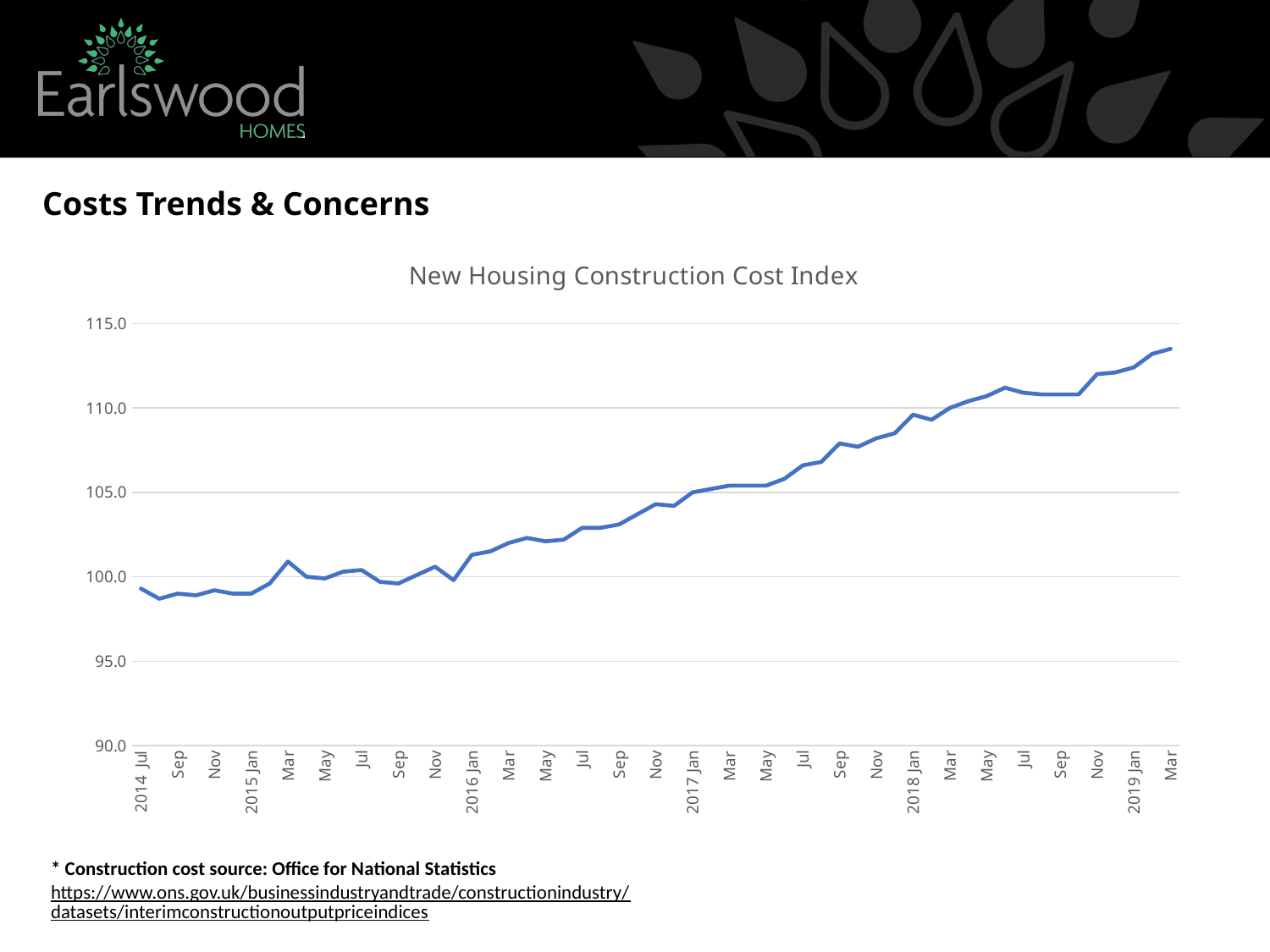
Is the value for 2017 Jul greater or less than 105.0? greater Is the value for 2014 Jul greater or less than 100.0? less Is the value for 2016 Jan greater or less than 100.0? greater Which is larger, the value for 2019 Mar or the value for 2014 Jul? 2019 Mar Which month has the highest value of the New Housing Construction Cost Index? 2019 Mar What is the title of the chart? New Housing Construction Cost Index What kind of chart is shown on the slide? line chart Overall, does the New Housing Construction Cost Index rise or fall from 2014 Jul to 2019 Mar? rise What is the highest value shown on the vertical axis? 115.0